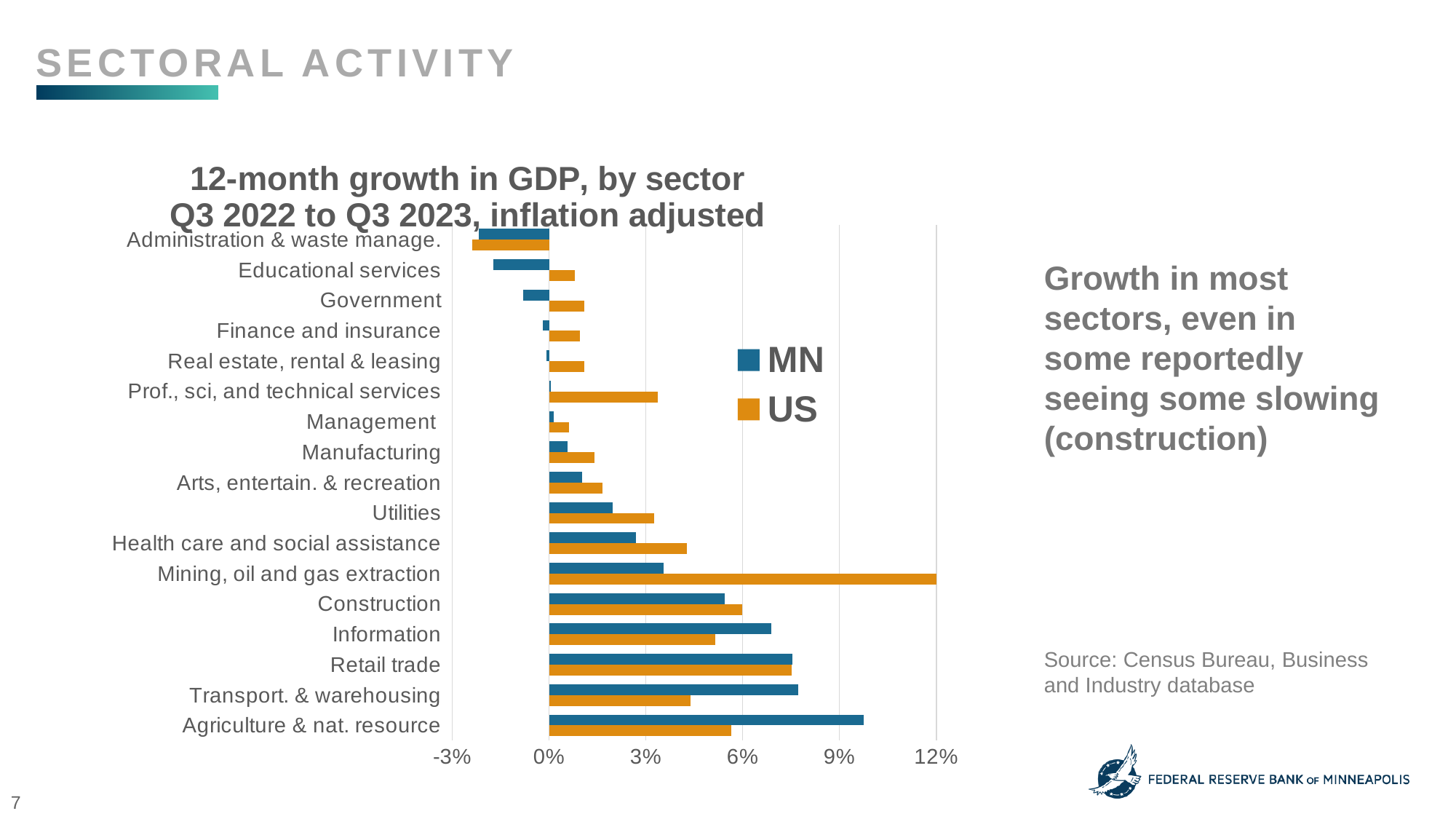
Which sector has the highest MN value? Agriculture & nat. resource Which sector has the highest US value? Mining, oil and gas extraction Is the MN value for Agriculture & nat. resource greater or less than 9%? greater For Mining, oil and gas extraction, which is larger, the MN value or the US value? US How many sectors are plotted on the chart? 17 For Information, which is larger, the MN value or the US value? MN How many series does the legend list? 2 Is the US value for Transport. & warehousing greater or less than 6%? less Is the MN value for Information greater or less than 6%? greater What is the title of the chart? 12-month growth in GDP, by sector Q3 2022 to Q3 2023, inflation adjusted Which sector has the lowest MN value? Administration & waste manage. What type of chart is shown on the slide? bar chart